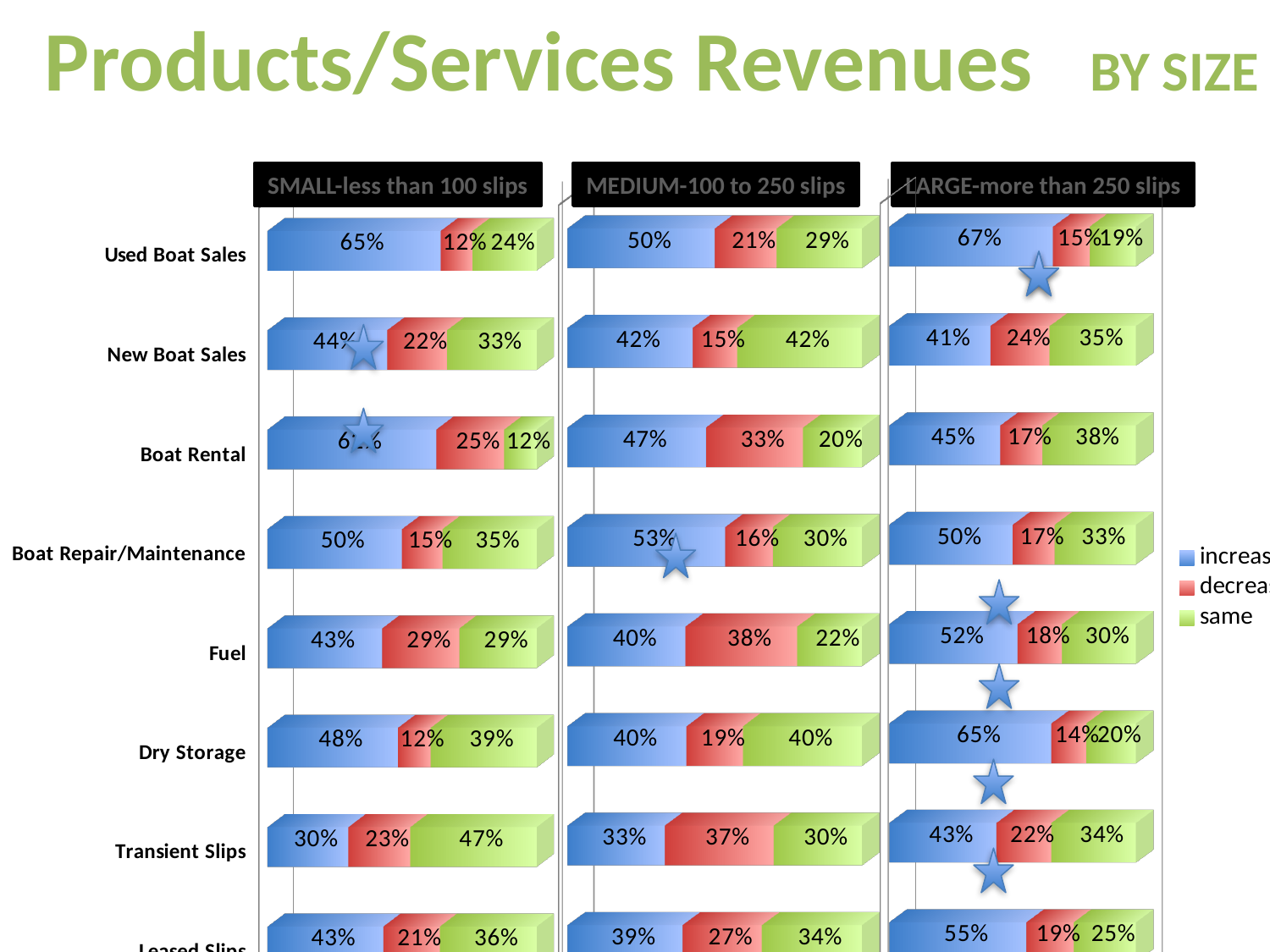
What kind of chart is used on this slide? stacked bar chart In the MEDIUM-100 to 250 slips chart, what is the difference between the red and green segment values for Boat Rental? 13 percentage points In the SMALL-less than 100 slips chart, which has the larger green segment value: Dry Storage or Transient Slips? Transient Slips What is the title of the middle chart? MEDIUM-100 to 250 slips How many series does the legend list? 3 In the MEDIUM-100 to 250 slips chart, what is the value of the red segment for Fuel? 38% In the SMALL-less than 100 slips chart, which category has the lowest blue segment value? Transient Slips In the SMALL-less than 100 slips chart, what is the value of the green segment for Used Boat Sales? 24% In the LARGE-more than 250 slips chart, which category has the highest blue segment value? Used Boat Sales In the LARGE-more than 250 slips chart, what is the value of the blue segment for Dry Storage? 65% In the MEDIUM-100 to 250 slips chart, for Transient Slips, which segment is larger: the blue or the red? red How many product/service categories are listed down the left side of the charts? 8